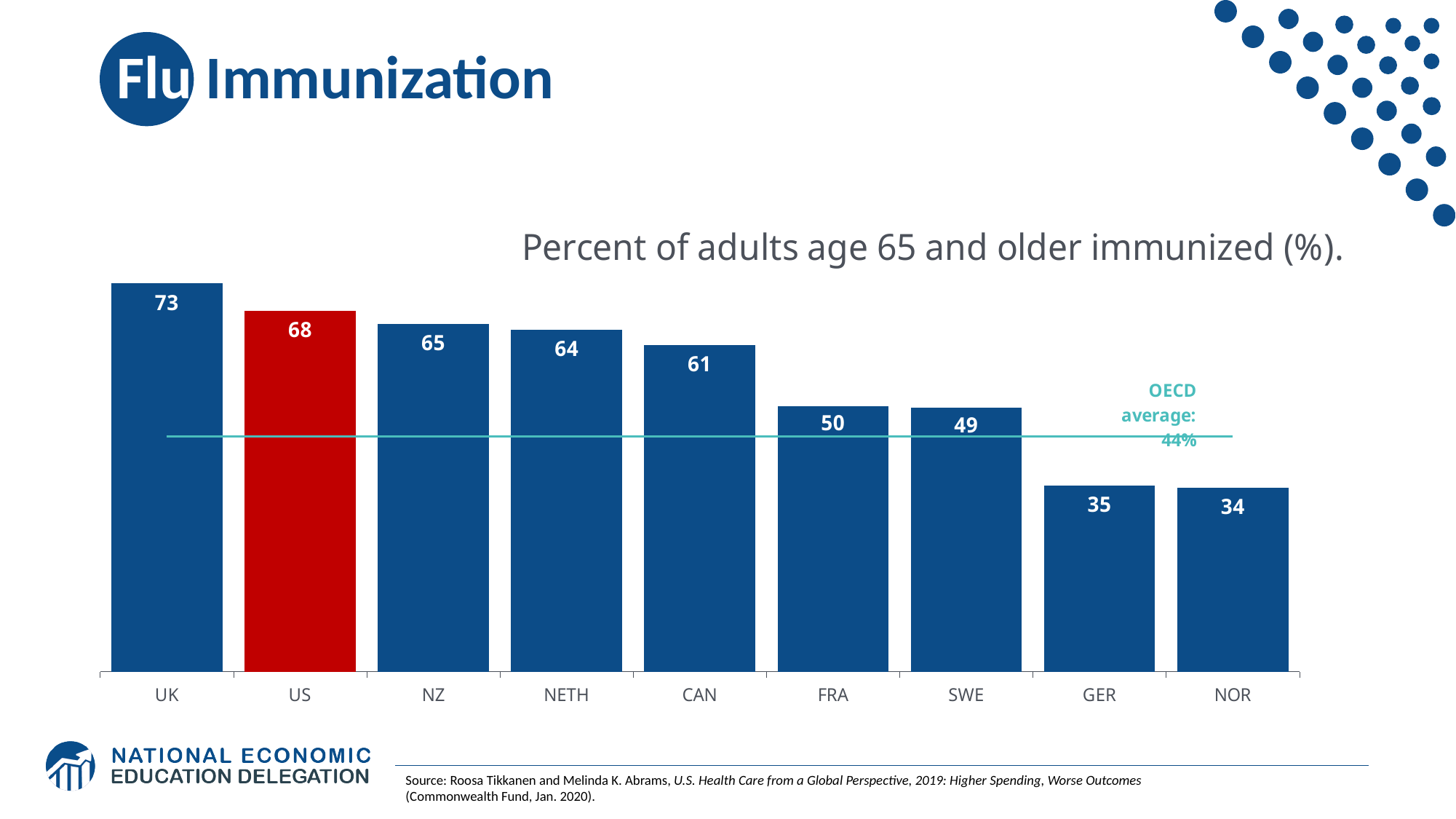
How many countries are shown on the chart? 9 What kind of chart is shown on the slide? Bar chart What is the difference between the values for the UK and the US? 5 Which country has the highest value? UK What is the value for NETH? 64 What is the value for FRA? 50 Do the values rise or fall from left to right along the x axis? Fall What OECD average value is marked by the horizontal line on the chart? 44% What is the value for the US? 68 Which is larger, the value for NZ or the value for SWE? NZ Which country has the lowest value? NOR What is the difference between the values for CAN and GER? 26